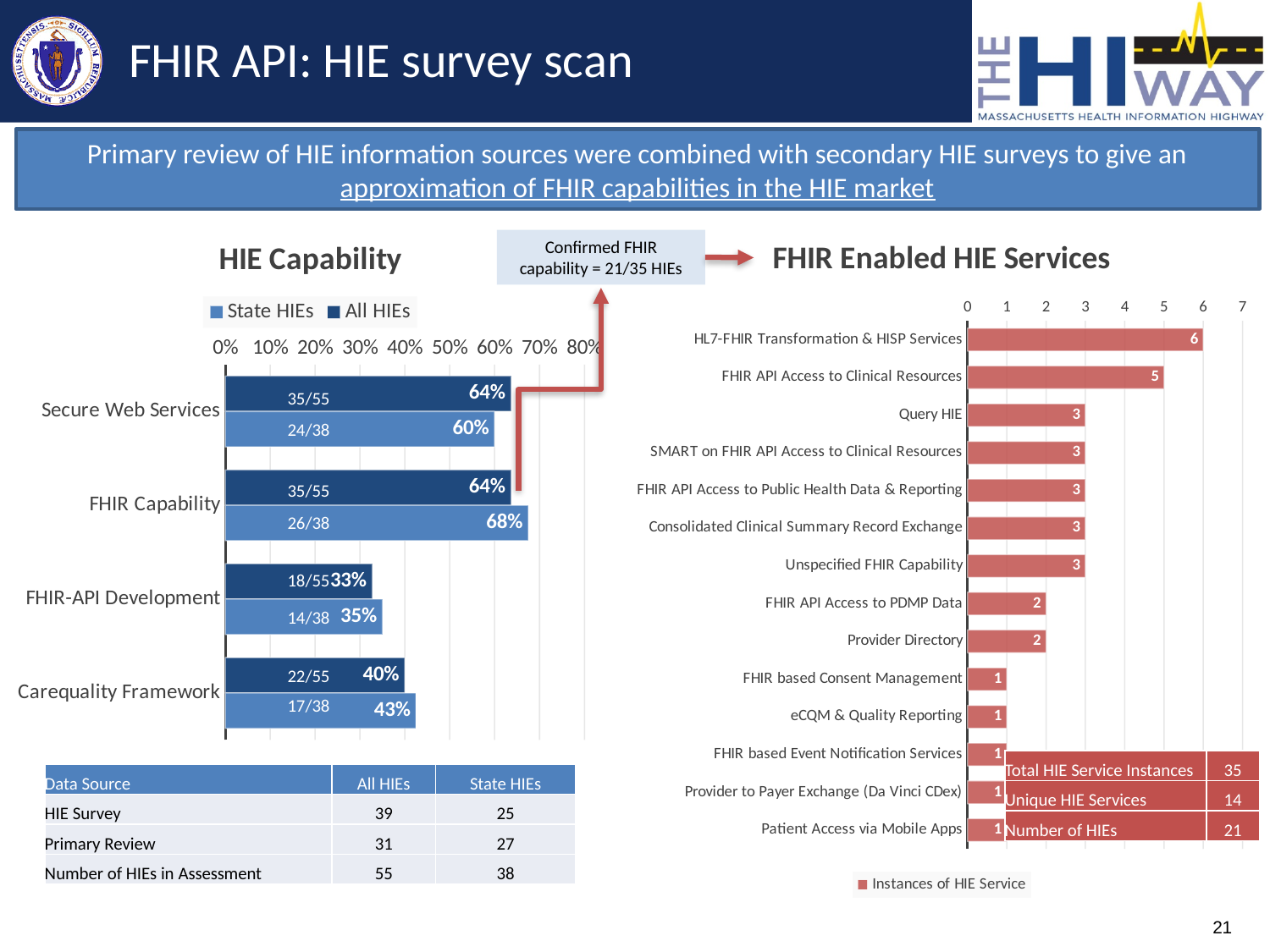
In the HIE Capability chart, which category has the lowest All HIEs value? FHIR-API Development In the FHIR Enabled HIE Services chart, what is the value for FHIR API Access to Clinical Resources? 5 What kind of chart is the FHIR Enabled HIE Services chart? Bar chart In the HIE Capability chart, what is the difference between the State HIEs and All HIEs values for Carequality Framework? 3% How many series does the legend of the HIE Capability chart list? 2 What is the legend entry of the FHIR Enabled HIE Services chart? Instances of HIE Service In the FHIR Enabled HIE Services chart, which category has the highest value? HL7-FHIR Transformation & HISP Services In the FHIR Enabled HIE Services chart, what is the difference between HL7-FHIR Transformation & HISP Services and Query HIE? 3 In the HIE Capability chart, which is larger for Secure Web Services: the State HIEs value or the All HIEs value? All HIEs How many categories are plotted in the FHIR Enabled HIE Services chart? 14 In the HIE Capability chart, what is the State HIEs value for FHIR Capability? 68% In the HIE Capability chart, what is the All HIEs value for Carequality Framework? 40%